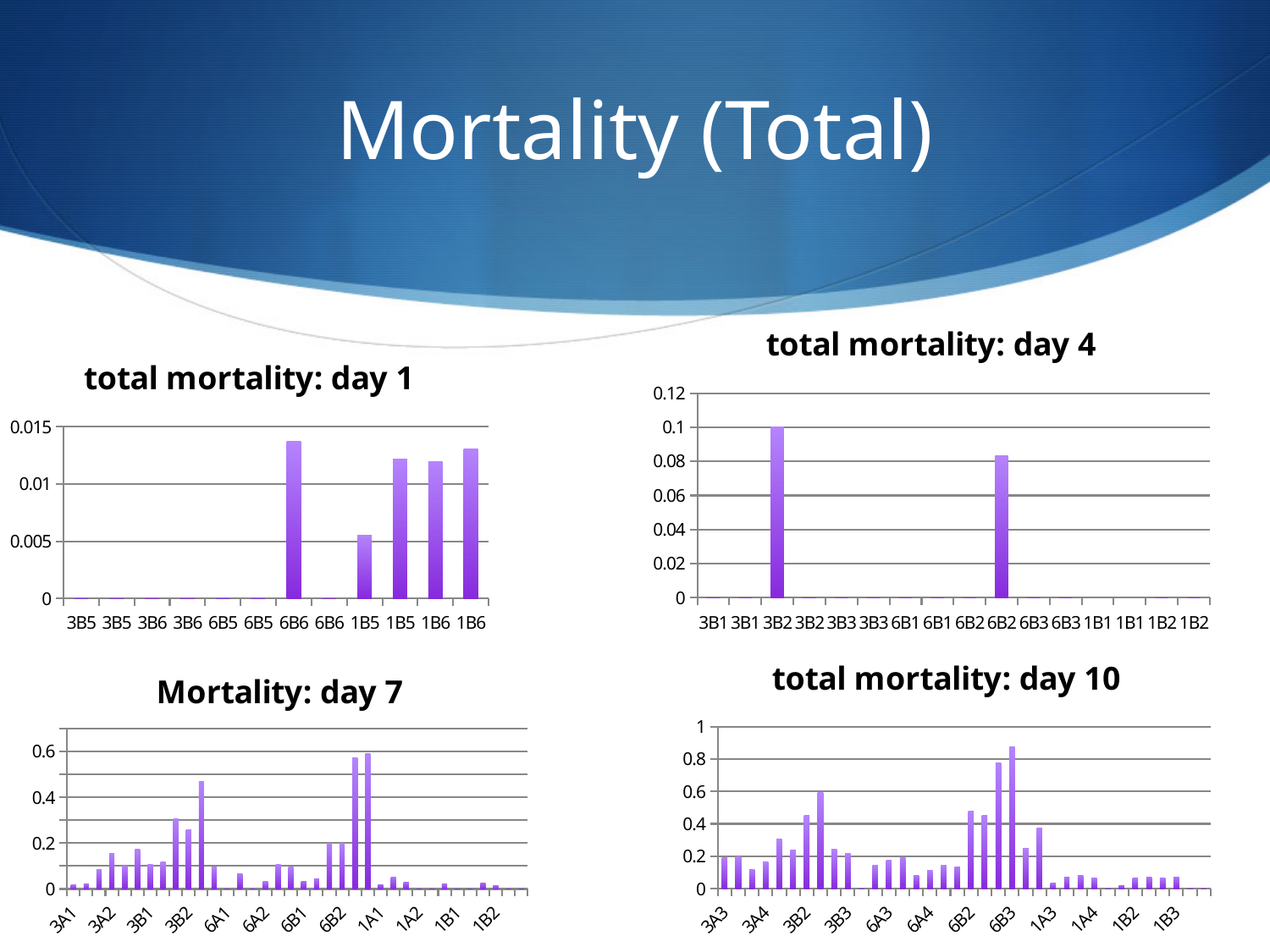
In the 'total mortality: day 4' chart, which category has the tallest bar? 3B2 In the 'total mortality: day 1' chart, which category has the tallest bar? 6B6 In the 'total mortality: day 4' chart, which is larger, the 3B2 bar or the 6B2 bar? 3B2 What is the title of the chart in the top right of the slide? total mortality: day 4 In the 'Mortality: day 7' chart, is the highest bar greater or less than 0.4? greater In the 'total mortality: day 4' chart, what is the value of the tallest bar (the first 3B2 bar)? 0.1 In the 'total mortality: day 1' chart, is the value for the first 6B6 bar greater or less than 0.01? greater In the 'total mortality: day 1' chart, is the value for the first 1B5 bar greater or less than 0.01? less How many categories are shown on the x axis of the 'total mortality: day 1' chart? 12 How many categories are shown on the x axis of the 'total mortality: day 4' chart? 16 What kind of chart is the 'total mortality: day 1' chart? bar chart